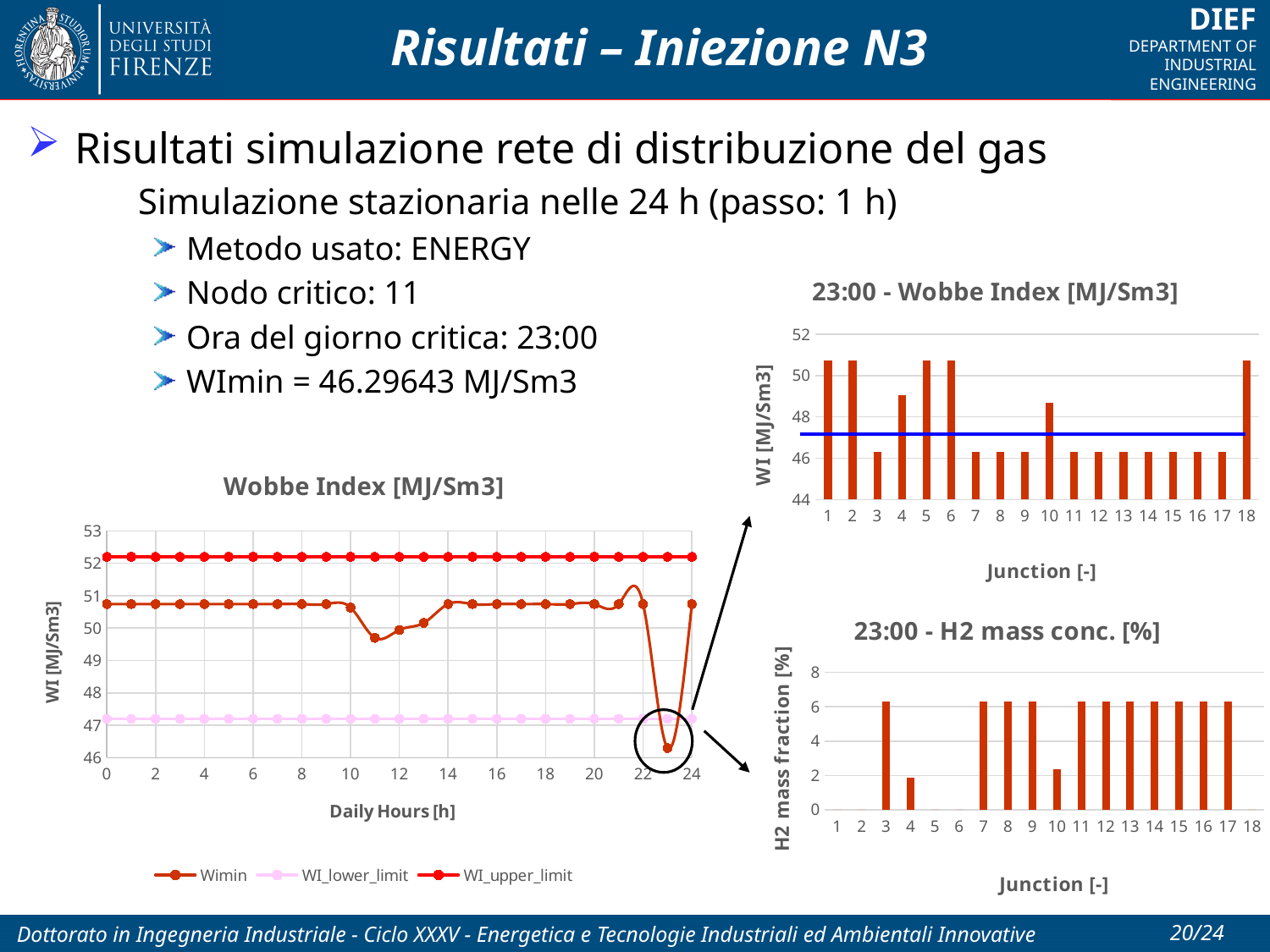
In the 'Wobbe Index [MJ/Sm3]' line chart, does the WI_lower_limit series rise, fall or stay flat across the daily hours? stays flat In the 'Wobbe Index [MJ/Sm3]' line chart, is the Wimin value at hour 23 greater or less than 47? less In the '23:00 - Wobbe Index [MJ/Sm3]' chart, which is larger, the value for junction 1 or junction 3? junction 1 In the 'Wobbe Index [MJ/Sm3]' line chart, at which daily hour does the Wimin series reach its lowest value? 23 How many junctions are shown on the x axis of the '23:00 - Wobbe Index [MJ/Sm3]' chart? 18 How many series does the legend of the 'Wobbe Index [MJ/Sm3]' line chart list? 3 In the 'Wobbe Index [MJ/Sm3]' line chart, is the WI_upper_limit series greater or less than 51? greater What are the legend entries of the 'Wobbe Index [MJ/Sm3]' line chart? Wimin, WI_lower_limit, WI_upper_limit In the '23:00 - Wobbe Index [MJ/Sm3]' chart, is the value for junction 10 greater or less than 48? greater In the '23:00 - H2 mass conc. [%]' chart, which is larger, the value for junction 3 or junction 4? junction 3 What kind of chart is the '23:00 - Wobbe Index [MJ/Sm3]' chart? bar chart What kind of chart is the 'Wobbe Index [MJ/Sm3]' chart on the left of the slide? line chart